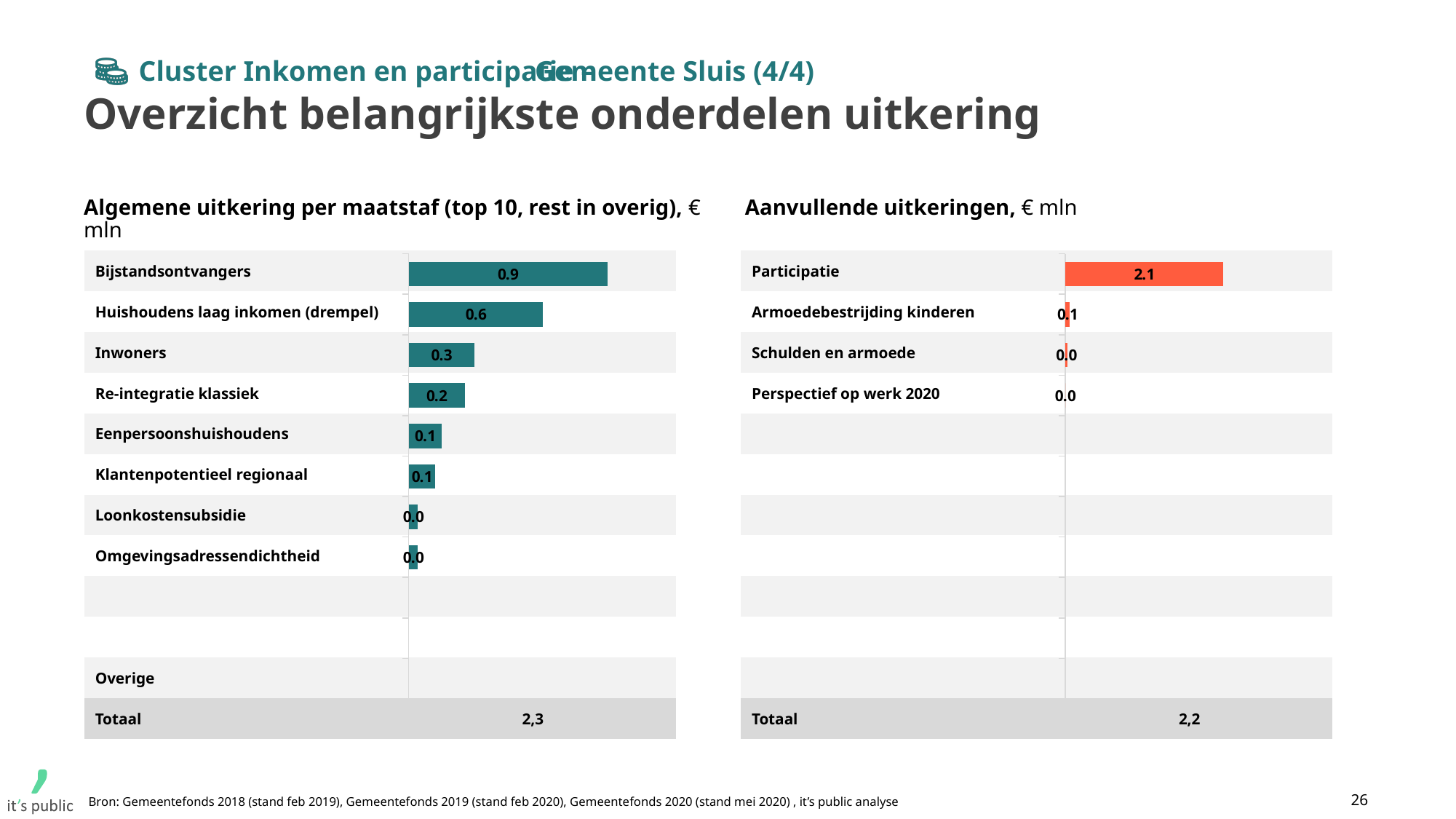
In the 'Algemene uitkering per maatstaf' chart, what is the value for Bijstandsontvangers? 0.9 In the 'Aanvullende uitkeringen' chart, which category has the highest value? Participatie In the 'Aanvullende uitkeringen' chart, how many labelled categories have bars or values shown? 4 In the 'Algemene uitkering per maatstaf' chart, what is the Totaal shown at the bottom? 2,3 In the 'Algemene uitkering per maatstaf' chart, which category has the highest value? Bijstandsontvangers In the 'Aanvullende uitkeringen' chart, what is the Totaal shown at the bottom? 2,2 What type of chart is used on the left side of the slide? Bar chart In the 'Algemene uitkering per maatstaf' chart, what is the difference between Bijstandsontvangers and Inwoners? 0.6 In the 'Algemene uitkering per maatstaf' chart, what is the value for Huishoudens laag inkomen (drempel)? 0.6 In the 'Aanvullende uitkeringen' chart, what is the value for Participatie? 2.1 In the 'Algemene uitkering per maatstaf' chart, which is larger: Inwoners or Re-integratie klassiek? Inwoners In the 'Aanvullende uitkeringen' chart, what is the value for Armoedebestrijding kinderen? 0.1